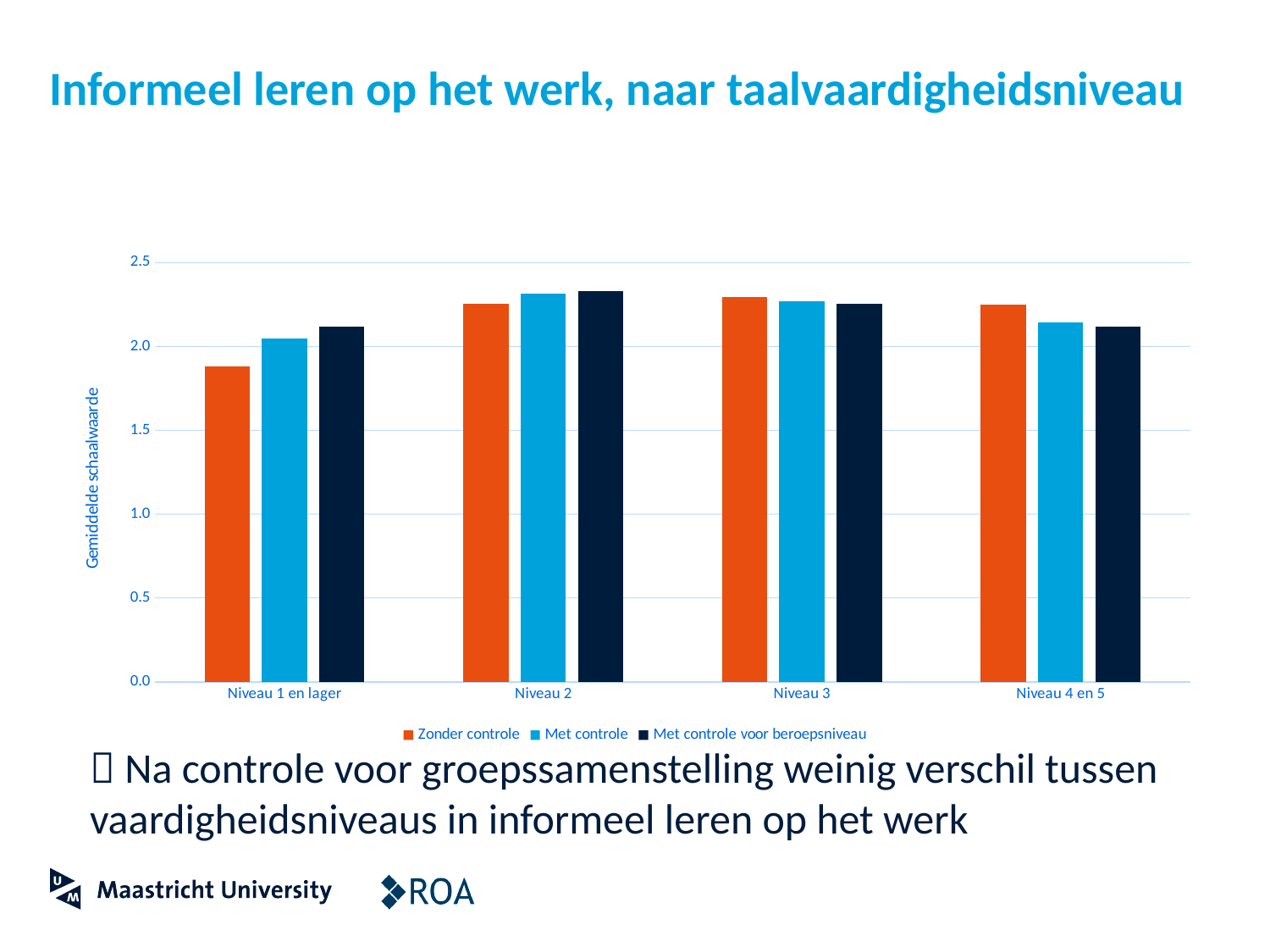
How many categories are shown on the x axis of the chart? 4 Is the value for Met controle voor beroepsniveau at Niveau 2 greater or less than 2.5? less Is the value for Met controle at Niveau 1 en lager greater or less than 2.0? greater Within Niveau 4 en 5, which series has the highest bar? Zonder controle What kind of chart is shown on the slide? bar chart Which category has the lowest value for the Zonder controle series? Niveau 1 en lager Is the value for Zonder controle at Niveau 1 en lager greater or less than 2.0? less Within Niveau 1 en lager, which series has the lowest bar? Zonder controle At Niveau 1 en lager, which is larger: the Zonder controle bar or the Met controle bar? Met controle For the Zonder controle series, which is larger: Niveau 1 en lager or Niveau 2? Niveau 2 How many series does the chart's legend list? 3 What is the title of the chart's vertical axis? Gemiddelde schaalwaarde